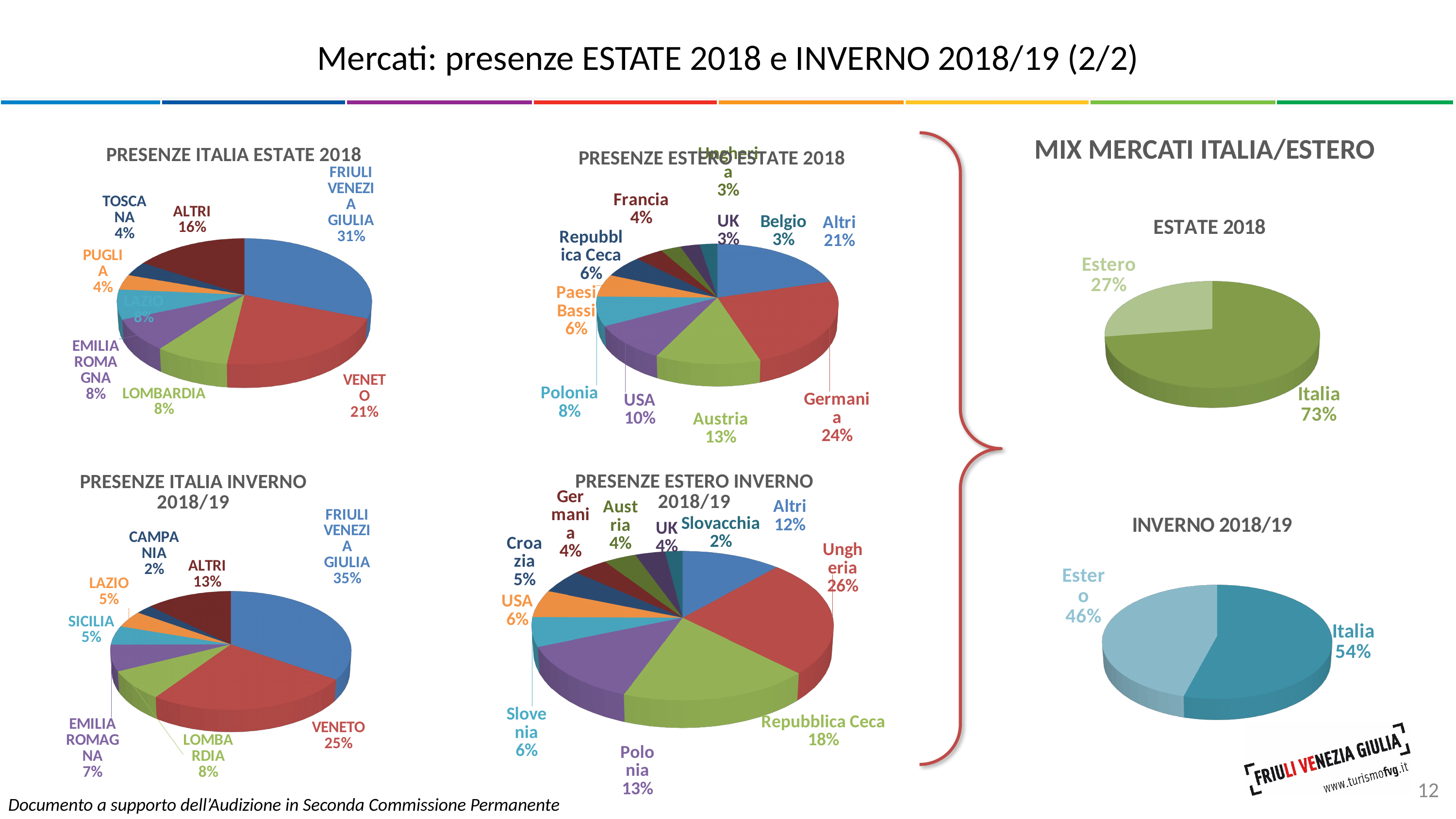
In the PRESENZE ESTERO INVERNO 2018/19 pie chart, which is larger, the share of Polonia or the share of Repubblica Ceca? Repubblica Ceca In the PRESENZE ESTERO INVERNO 2018/19 pie chart, which country has the largest share? Ungheria In the ESTATE 2018 pie chart under MIX MERCATI ITALIA/ESTERO, what share does Estero have? 27% What type of chart is used for PRESENZE ITALIA ESTATE 2018? Pie chart In the PRESENZE ESTERO ESTATE 2018 pie chart, what is the difference between the shares of Germania and Austria? 11% In the PRESENZE ITALIA ESTATE 2018 pie chart, which region has the largest share? FRIULI VENEZIA GIULIA In the PRESENZE ESTERO ESTATE 2018 pie chart, what share does Germania have? 24% In the PRESENZE ITALIA ESTATE 2018 pie chart, what share does FRIULI VENEZIA GIULIA have? 31% In the PRESENZE ITALIA INVERNO 2018/19 pie chart, which region has the smallest share? CAMPANIA How many slices does the PRESENZE ESTERO INVERNO 2018/19 pie chart have? 11 In the INVERNO 2018/19 pie chart under MIX MERCATI ITALIA/ESTERO, what is the difference between the Italia and Estero shares? 8% In the PRESENZE ITALIA INVERNO 2018/19 pie chart, what share does VENETO have? 25%